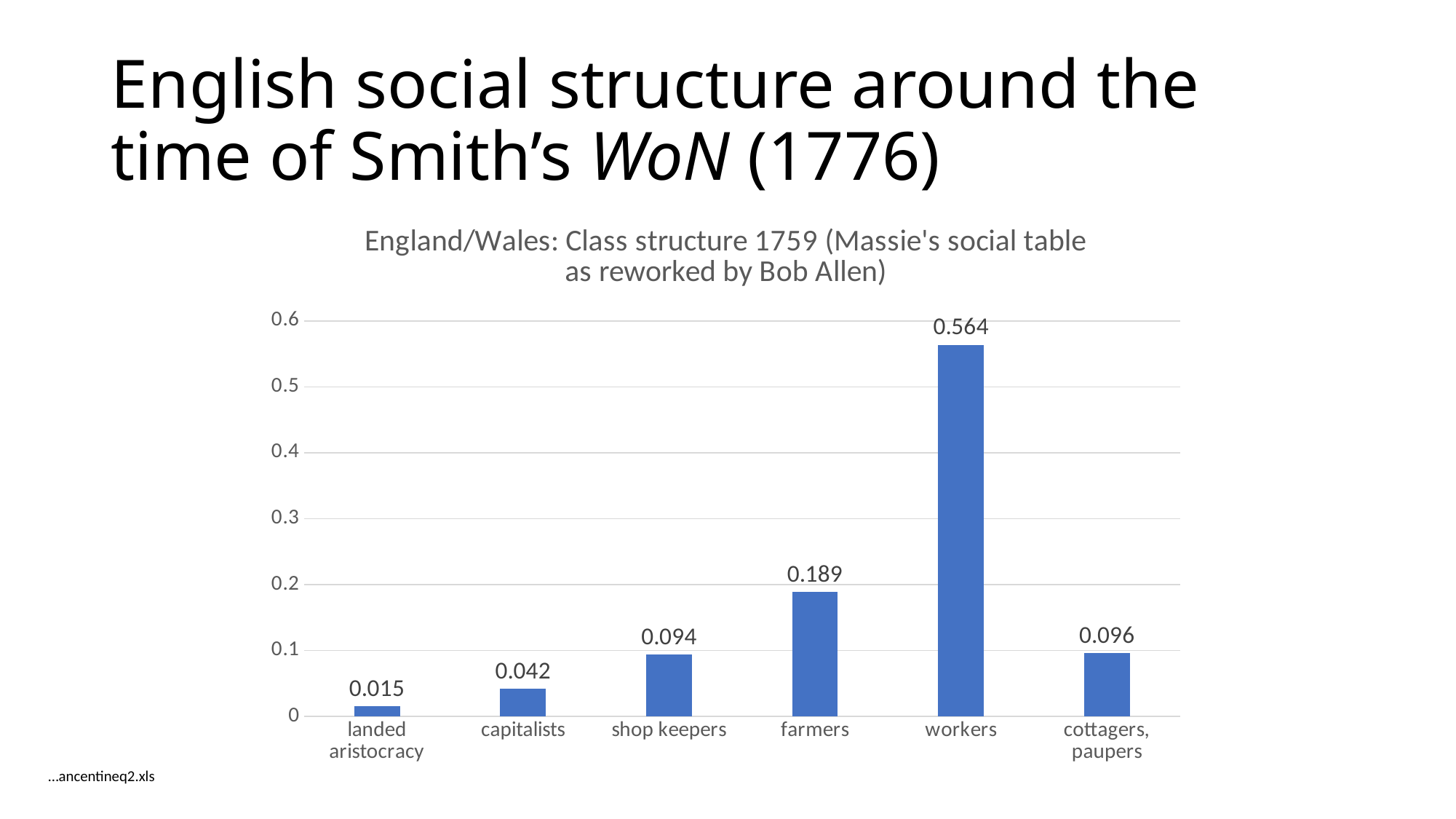
How many categories are shown on the x axis? 6 Is the value for workers greater or less than 0.5? greater What kind of chart is shown on the slide? bar chart Which category has the highest value? workers Which category has the lowest value? landed aristocracy Which is larger, the value for farmers or the value for cottagers, paupers? farmers What is the difference between the values for workers and farmers? 0.375 What is the difference between the values for shop keepers and capitalists? 0.052 What is the value for landed aristocracy? 0.015 What is the value for workers? 0.564 What is the value for farmers? 0.189 What is the value for cottagers, paupers? 0.096